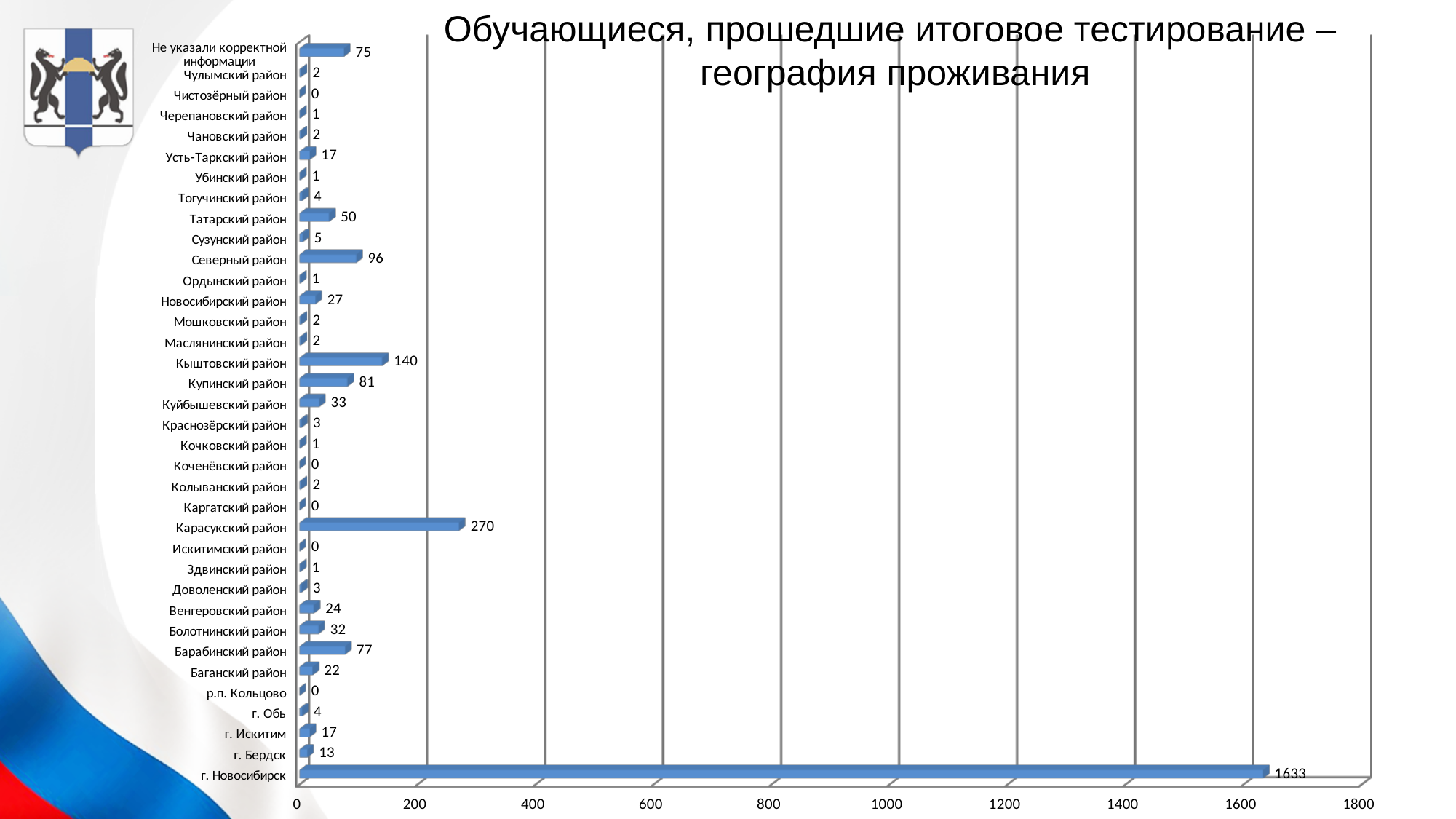
What is the value for Северный район? 96 What is the value for Кыштовский район? 140 Which category has the highest value? г. Новосибирск How many categories are shown on the chart? 36 What is the value for Карасукский район? 270 What is the value for Усть-Таркский район? 17 Which is larger, the value for Купинский район or the value for Барабинский район? Купинский район What is the title of the chart? Обучающиеся, прошедшие итоговое тестирование – география проживания What kind of chart is shown on the slide? bar chart What is the difference between the values for Карасукский район and Кыштовский район? 130 Is the value for г. Новосибирск greater or less than 1600? greater What is the value for г. Новосибирск? 1633